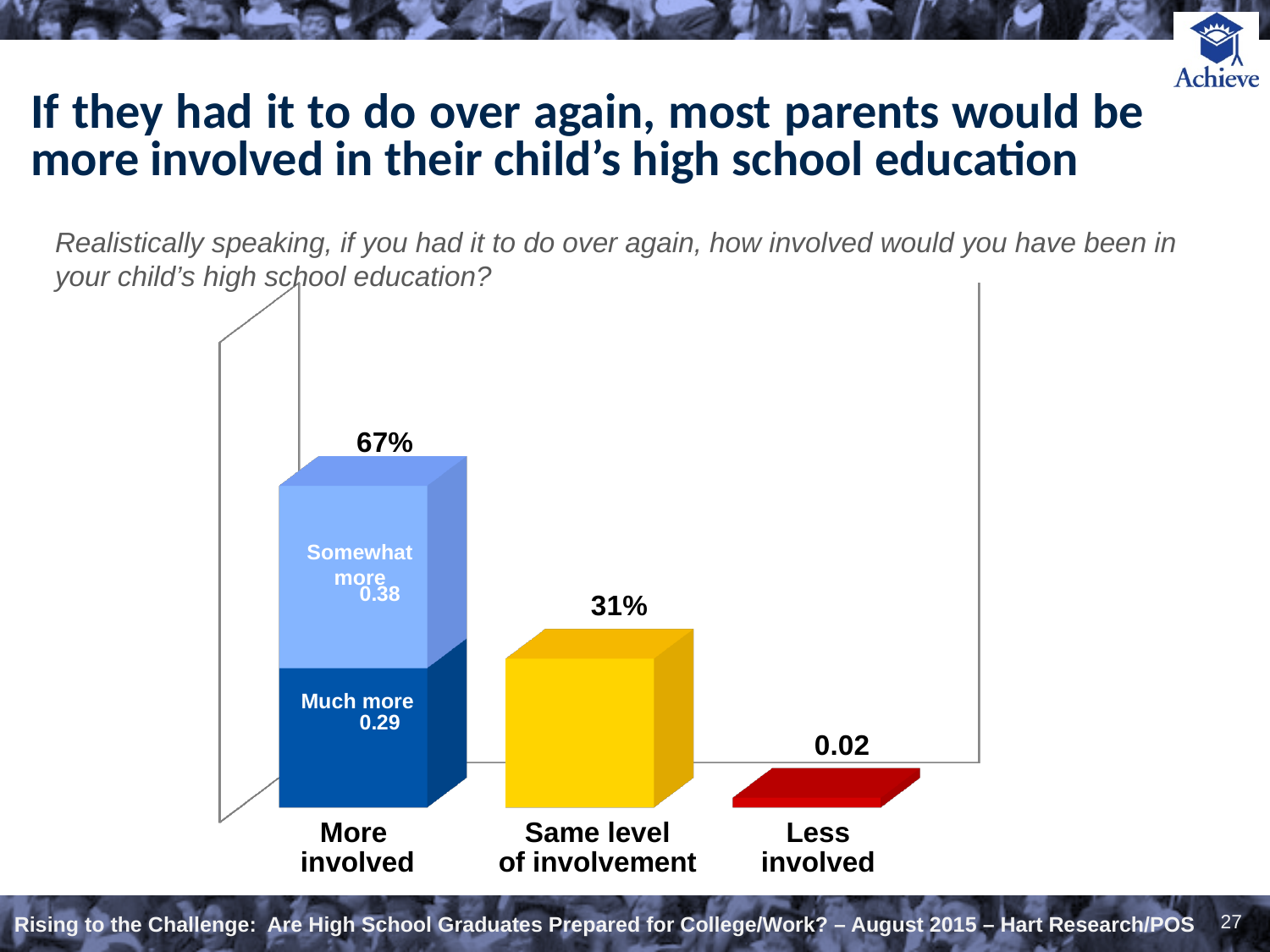
What value is labeled on the 'Somewhat more' segment of the 'More involved' bar? 0.38 Which category has the highest value? More involved What percentage of parents said they would be more involved? 67% What value is labeled on the 'Much more' segment of the 'More involved' bar? 0.29 What is the difference between the 'More involved' total and the 'Same level of involvement' value? 36% Do the values rise or fall moving from left to right along the x axis? Fall What value is shown for 'Same level of involvement'? 31% How many categories are shown along the x axis? 3 What kind of chart is shown on the slide? Bar chart Which category has the lowest value? Less involved Which is larger: 'Same level of involvement' or 'Less involved'? Same level of involvement What value is shown for 'Less involved'? 0.02